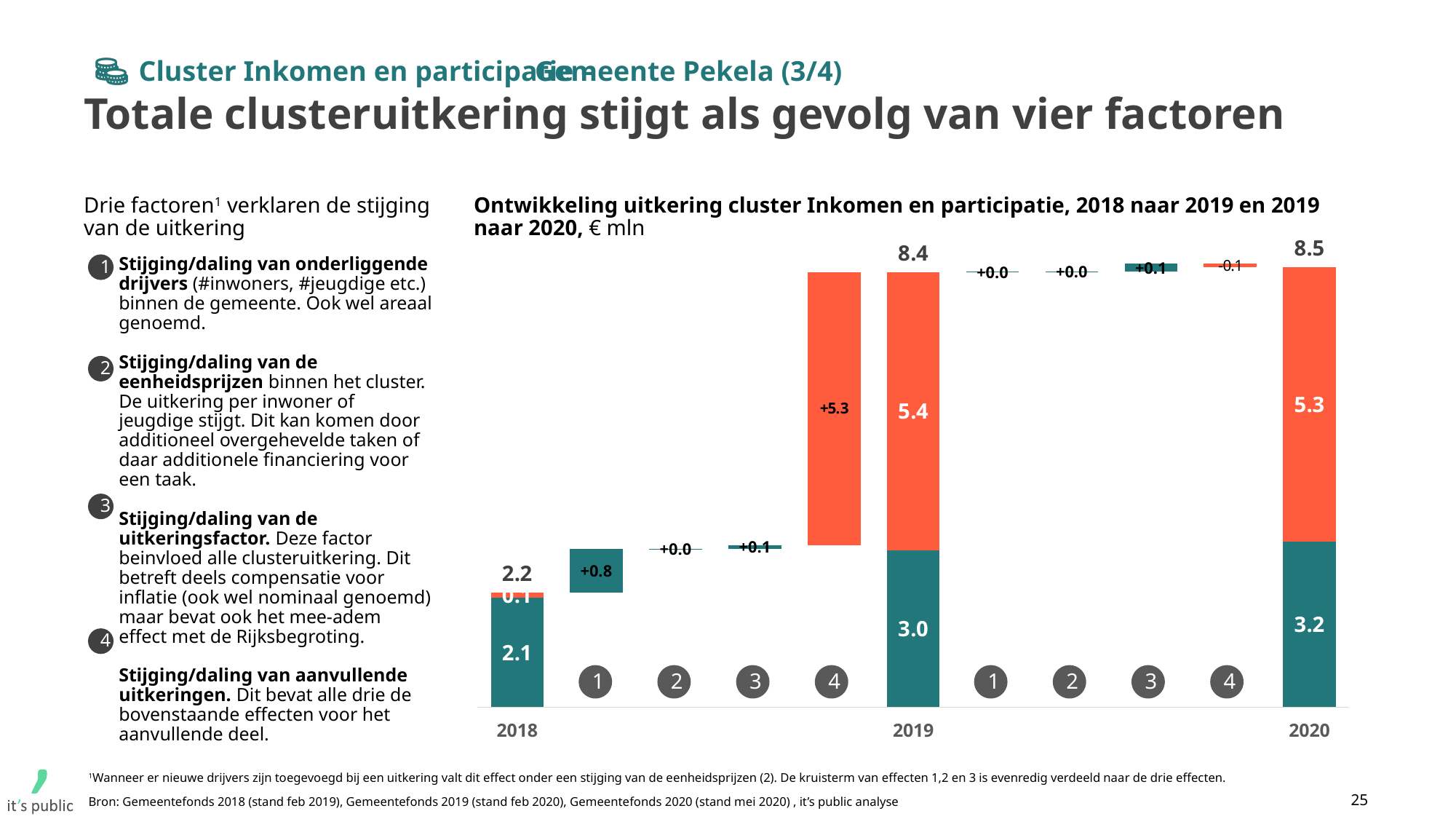
What is the orange (upper) segment value of the 2019 bar? 5.4 What is the total uitkering for 2019 shown on the chart? 8.4 What is the value of factor 1 in the change from 2018 to 2019? +0.8 What is the total uitkering for 2018 shown on the chart? 2.2 Which factor contributes the largest change between 2018 and 2019? 4 What is the value of factor 4 in the change from 2019 to 2020? -0.1 What unit is the chart expressed in, according to its title? € mln What is the value of factor 4 in the change from 2018 to 2019? +5.3 What is the teal (lower) segment value of the 2020 bar? 3.2 What is the total uitkering for 2020 shown on the chart? 8.5 What is the difference between the 2019 total and the 2018 total? 6.2 Is the 2020 total larger or smaller than the 2018 total? larger